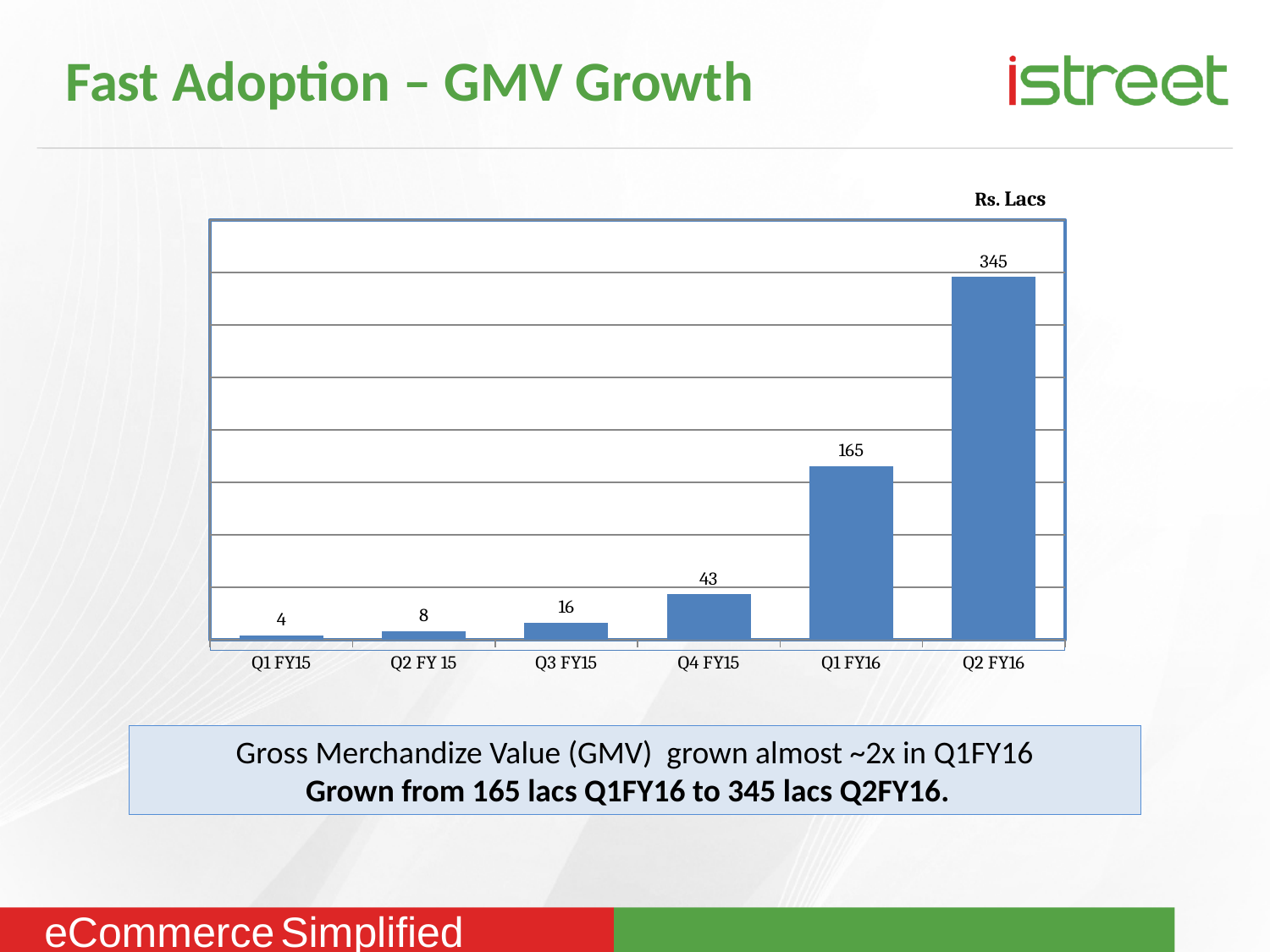
How many quarters are shown on the chart? 6 What is the GMV value for Q1 FY16? 165 What is the difference in GMV between Q4 FY15 and Q3 FY15? 27 Which is larger, the GMV for Q2 FY 15 or Q3 FY15? Q3 FY15 What is the GMV value for Q4 FY15? 43 What unit is indicated above the chart? Rs. Lacs Which quarter has the lowest GMV? Q1 FY15 Do the GMV values rise or fall from Q1 FY15 to Q2 FY16? Rise What kind of chart is shown on the slide? Bar chart What is the difference in GMV between Q2 FY16 and Q1 FY16? 180 What is the GMV value for Q1 FY15? 4 Which quarter has the highest GMV? Q2 FY16